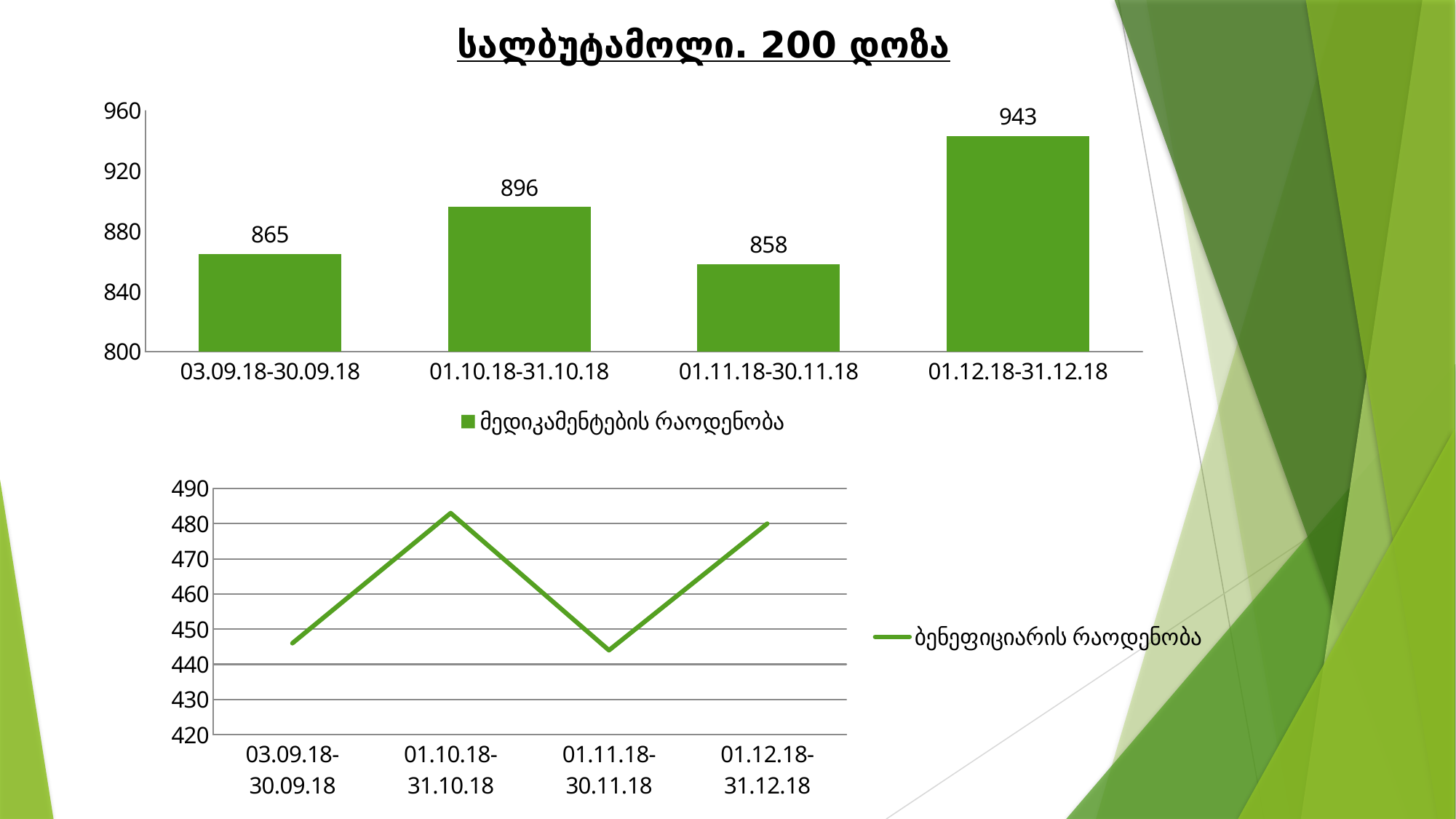
In the bottom line chart, is the value for 01.10.18-31.10.18 greater or less than 470? greater How many bars are in the top bar chart? 4 In the top bar chart, which is larger: the value for 01.10.18-31.10.18 or for 03.09.18-30.09.18? 01.10.18-31.10.18 In the top bar chart, what is the value for 03.09.18-30.09.18? 865 In the top bar chart, which period has the lowest value? 01.11.18-30.11.18 In the top bar chart, which period has the highest value? 01.12.18-31.12.18 What kind of chart is the bottom chart? line chart In the top bar chart, what is the value for 01.12.18-31.12.18? 943 In the bottom line chart, which period has the highest value? 01.10.18-31.10.18 In the bottom line chart, is the value for 01.11.18-30.11.18 greater or less than 450? less What is the title of the slide above the charts? სალბუტამოლი. 200 დოზა In the top bar chart, what is the difference between the values for 01.12.18-31.12.18 and 01.11.18-30.11.18? 85